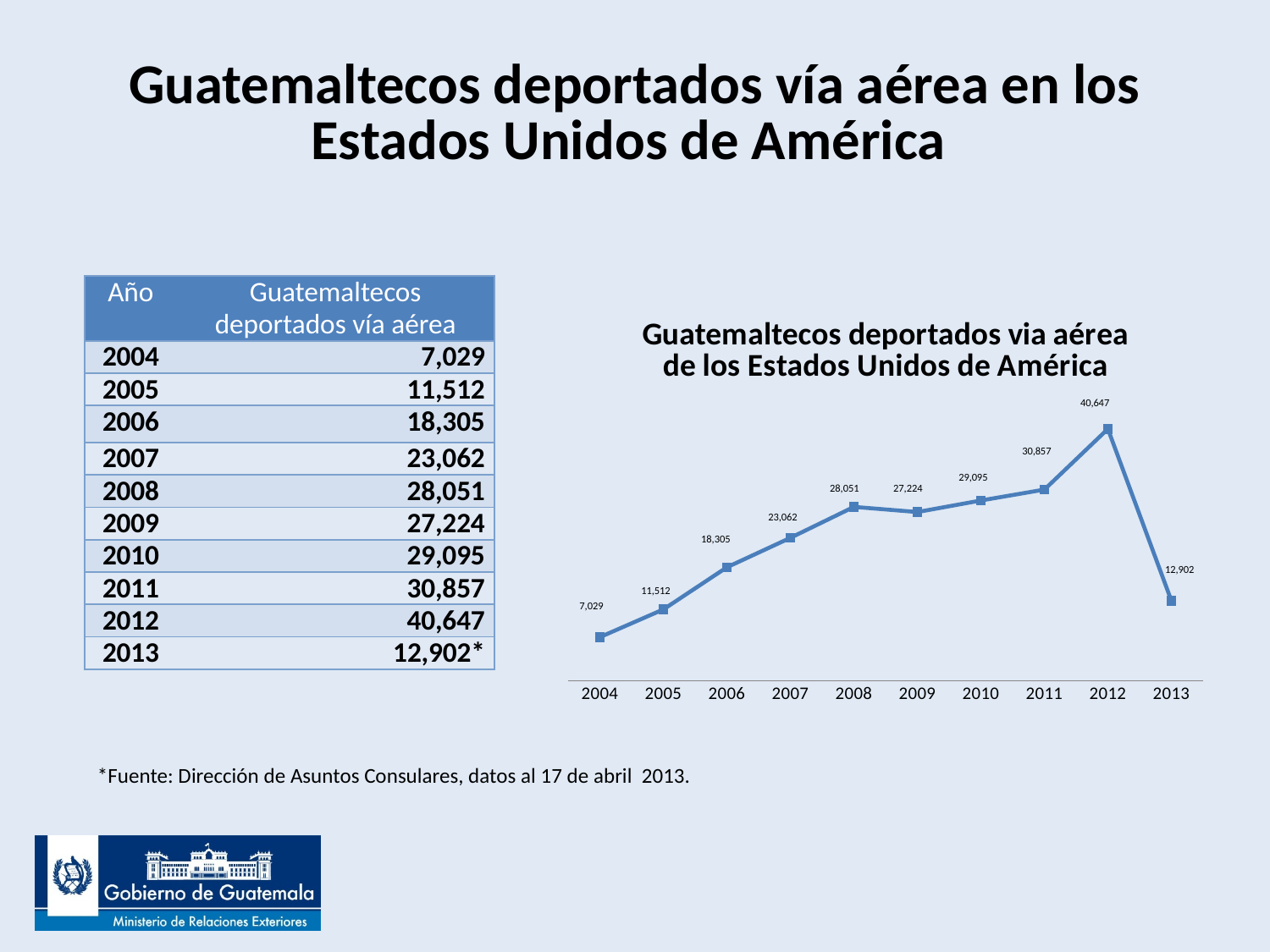
What is the difference between the values for 2008 and 2009? 827 What is the difference between the values for 2012 and 2011? 9,790 Which year has the highest value in the chart? 2012 What is the title of the chart? Guatemaltecos deportados via aérea de los Estados Unidos de América Which is larger, the value for 2010 or the value for 2013? 2010 What type of chart is shown on the slide? line chart What is the value for 2004 in the chart? 7,029 What is the value for 2009 in the chart? 27,224 How many years are plotted on the x axis of the chart? 10 Which year has the lowest value in the chart? 2004 What is the value for 2012 in the chart? 40,647 Do the values rise or fall from 2004 to 2008? rise